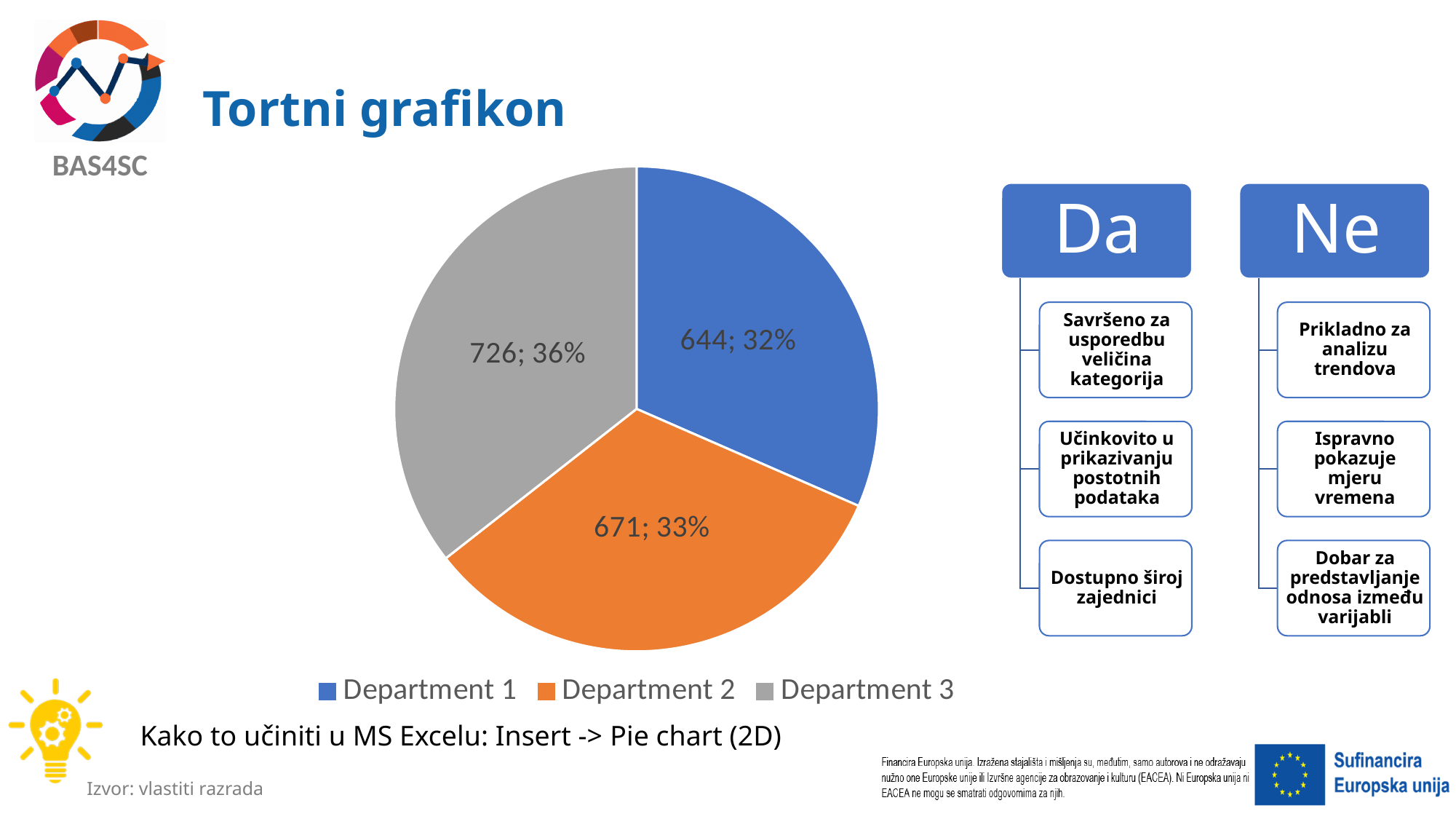
What percentage share of the pie does Department 1 have? 32% What type of chart is shown on the slide? Pie chart What is the difference between the values for Department 3 and Department 1? 82 What is the value for Department 2 in the pie chart? 671 Which department has the smallest slice of the pie? Department 1 Which is larger, the value for Department 2 or the value for Department 1? Department 2 What is the value for Department 1 in the pie chart? 644 What is the value for Department 3 in the pie chart? 726 How many slices does the pie chart have? 3 What percentage share of the pie does Department 3 have? 36% Which department has the largest slice of the pie? Department 3 What colour is the slice for Department 2? Orange